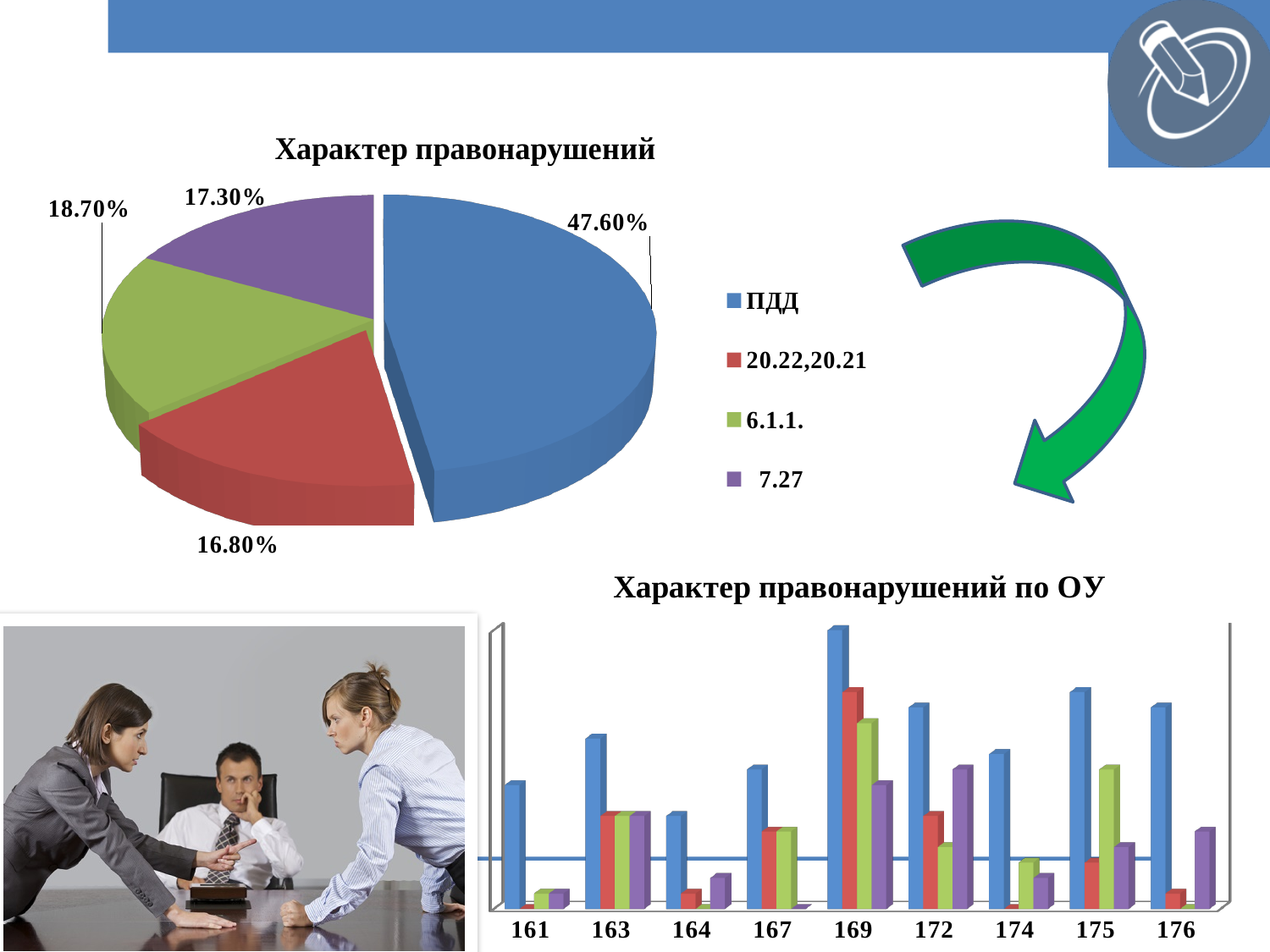
What type of chart is 'Характер правонарушений по ОУ'? Bar chart How many categories are shown on the x axis of the chart 'Характер правонарушений по ОУ'? 9 In the pie chart 'Характер правонарушений', what percentage is shown for the 7.27 slice? 17.30% How many entries does the legend of the pie chart 'Характер правонарушений' list? 4 In the pie chart 'Характер правонарушений', which category has the smallest share? 20.22,20.21 In the pie chart 'Характер правонарушений', what share is labelled for the ПДД slice? 47.60% What type of chart is 'Характер правонарушений'? Pie chart In the pie chart 'Характер правонарушений', which category has the largest share? ПДД In the pie chart 'Характер правонарушений', what is the difference between the ПДД share and the 20.22,20.21 share? 30.80% In the pie chart 'Характер правонарушений', which is larger: the 6.1.1. share or the 7.27 share? 6.1.1. In the pie chart 'Характер правонарушений', what percentage is shown for the 6.1.1. slice? 18.70% In the chart 'Характер правонарушений по ОУ', which category has the tallest blue bar? 169